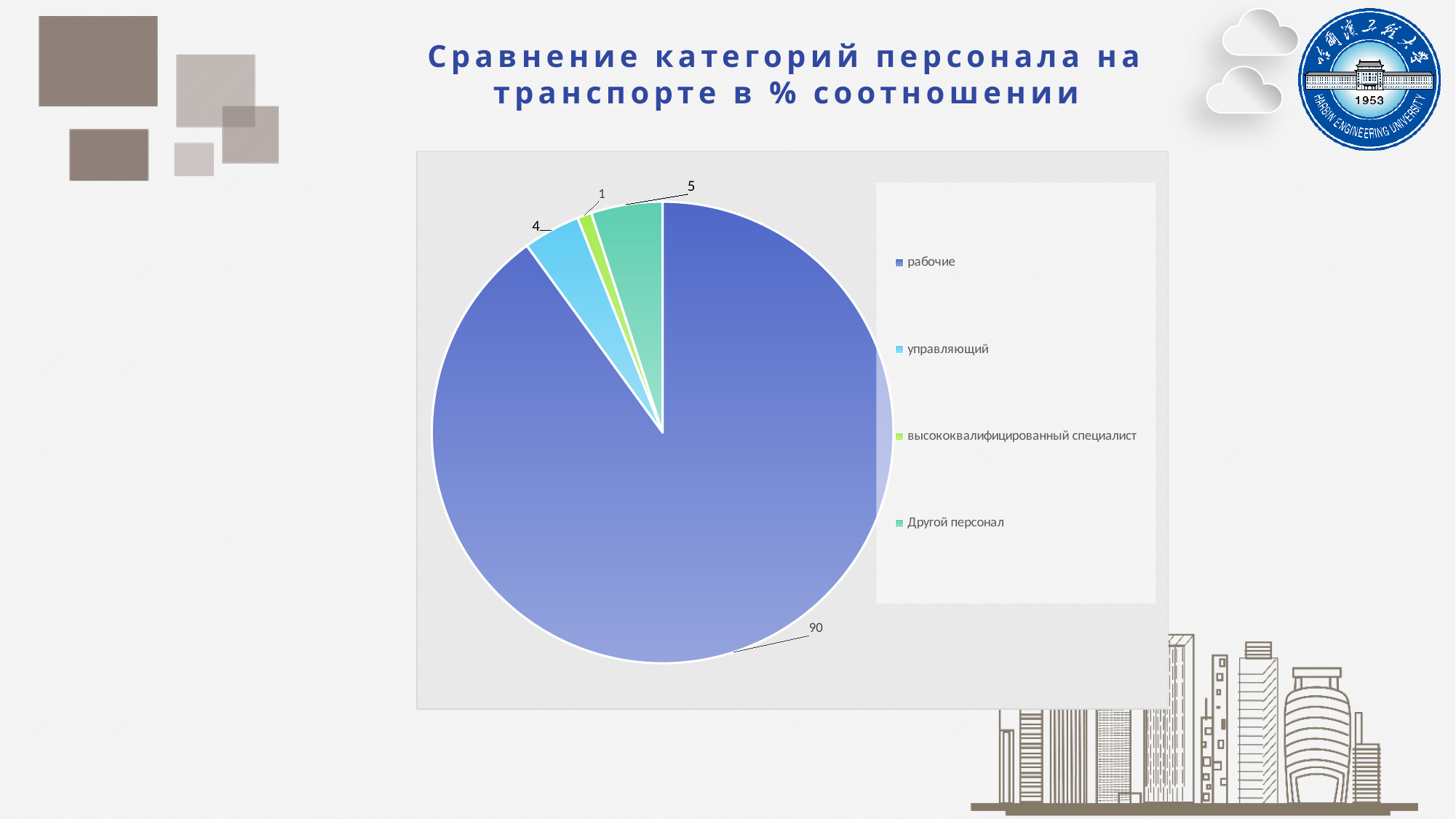
What is the difference between the values for рабочие and Другой персонал? 85 What is the value for высококвалифицированный специалист? 1 What is the title of the slide containing the chart? Сравнение категорий персонала на транспорте в % соотношении What is the difference between the values for Другой персонал and управляющий? 1 What is the value for рабочие? 90 Which category has the largest slice of the pie? рабочие What is the value for управляющий? 4 Which is larger, the value for управляющий or the value for Другой персонал? Другой персонал Which category has the smallest slice of the pie? высококвалифицированный специалист How many categories does the pie chart show? 4 What is the value for Другой персонал? 5 What kind of chart is shown on the slide? pie chart